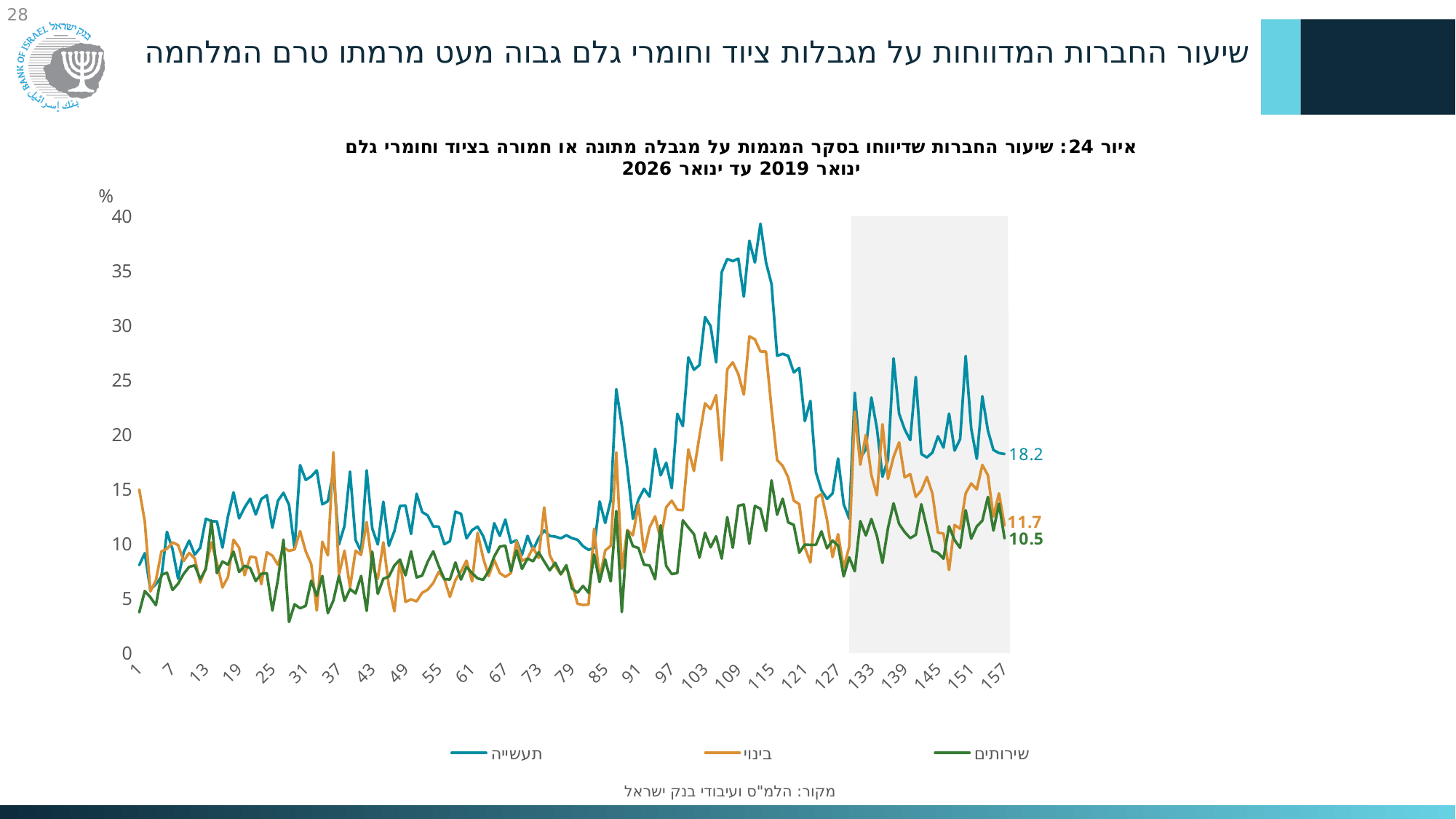
What unit is shown on the y axis? % Which series has the lowest final labelled value? שירותים What is the difference between the final labelled values of בינוי and שירותים? 1.2 What is the final labelled value of the תעשייה series? 18.2 Which series has the highest final labelled value? תעשייה How many series does the legend list? 3 Which series reaches the highest peak on the chart, around point 115? תעשייה What type of chart is shown on the slide? line chart What is the final labelled value of the בינוי series? 11.7 What is the final labelled value of the שירותים series? 10.5 What is the difference between the final labelled values of תעשייה and שירותים? 7.7 Is the final labelled value of the תעשייה series greater or less than 15? greater